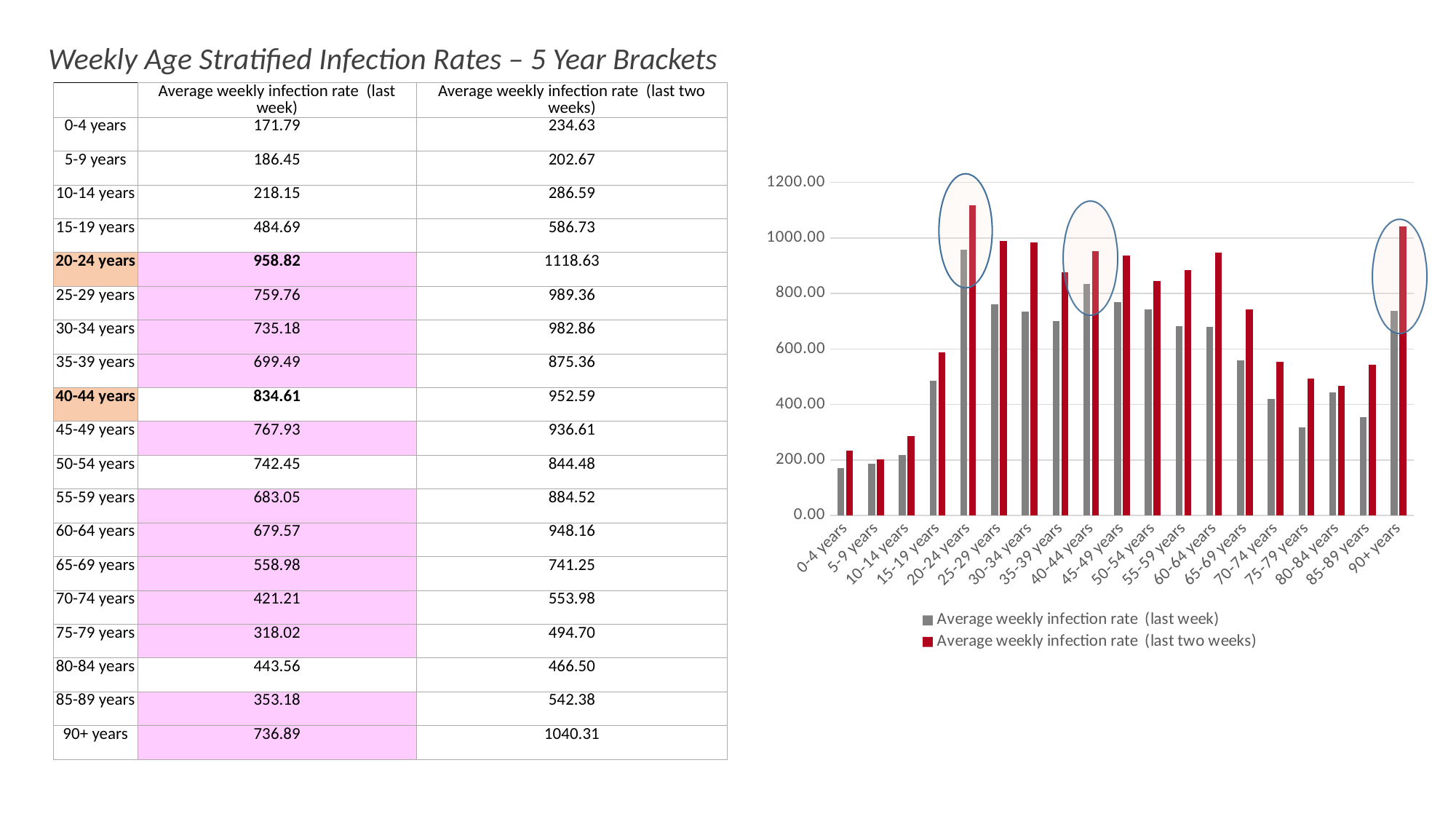
Is the average weekly infection rate (last week) for 85-89 years greater or less than 400? less How many age brackets are plotted along the x axis of the chart? 19 What colour are the bars for the average weekly infection rate (last two weeks) series? red What is the average weekly infection rate (last week) for 20-24 years? 958.82 What is the average weekly infection rate (last two weeks) for 90+ years? 1040.31 How many series does the chart's legend list? 2 Which age bracket has the highest average weekly infection rate (last two weeks)? 20-24 years For 20-24 years, how much higher is the last two weeks rate than the last week rate? 159.81 Which has the larger average weekly infection rate (last week): 40-44 years or 45-49 years? 40-44 years Do the last week infection rates rise or fall from 0-4 years to 20-24 years? rise Which age bracket has the lowest average weekly infection rate (last week)? 0-4 years What kind of chart is shown on the slide? bar chart